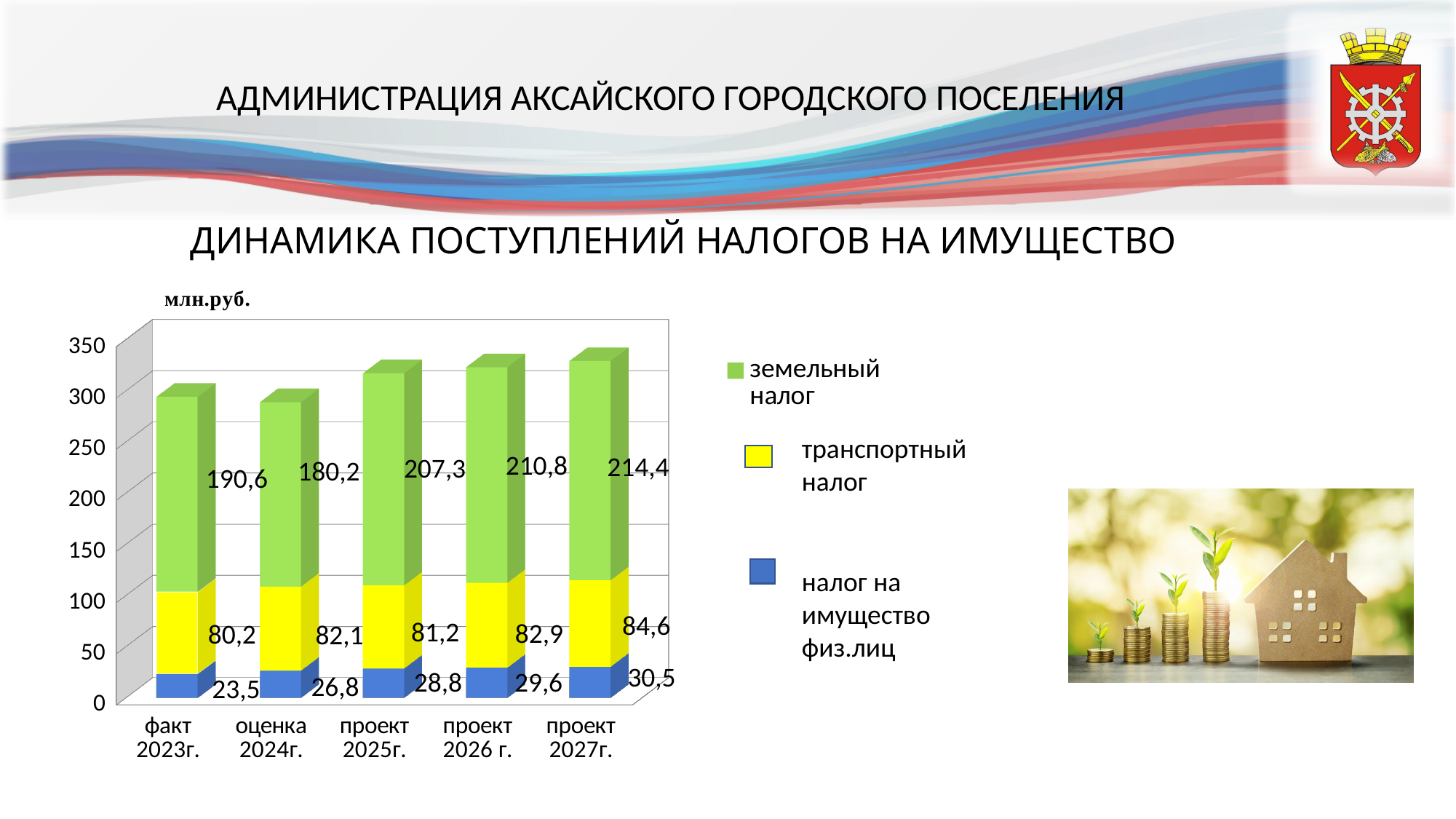
How many series does the legend list? 3 What kind of chart is shown on the slide? stacked bar chart What is the difference between земельный налог for проект 2027г. and факт 2023г.? 23,8 Does налог на имущество физ.лиц rise or fall from факт 2023г. to проект 2027г.? rise How many categories are shown on the x axis? 5 What is the value of земельный налог for факт 2023г.? 190,6 What is the total of the stacked bar for проект 2027г.? 329,5 What is the value of транспортный налог for проект 2026 г.? 82,9 In which category is земельный налог the highest? проект 2027г. Which is larger: транспортный налог for оценка 2024г. or for проект 2025г.? оценка 2024г. In which category is земельный налог the lowest? оценка 2024г. What is the value of налог на имущество физ.лиц for оценка 2024г.? 26,8